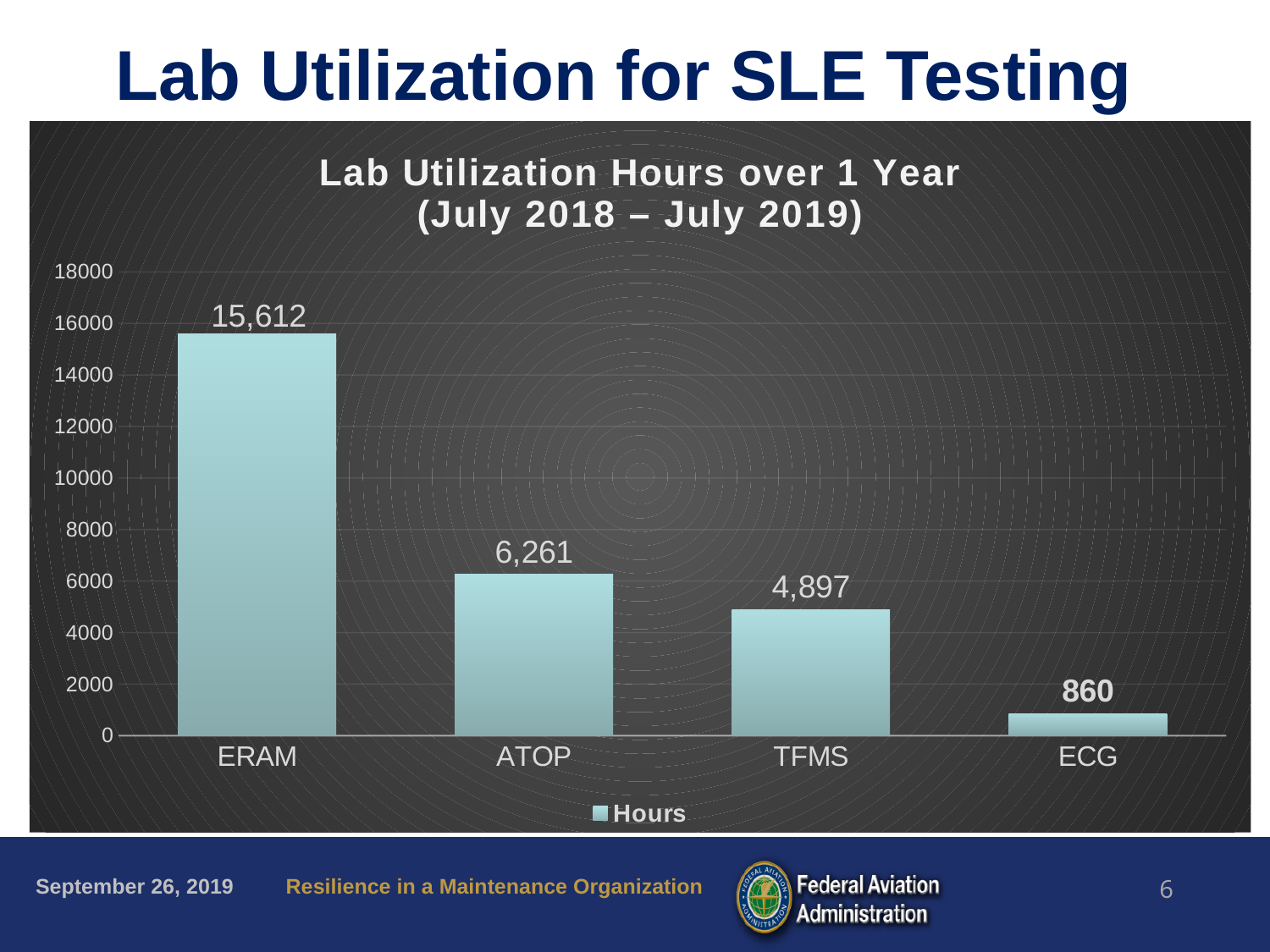
What is the value for ATOP? 6,261 Which category has the lowest value? ECG Which is larger, the value for TFMS or the value for ECG? TFMS How many categories are shown on the x axis? 4 What is the value for ECG? 860 Which category has the highest value? ERAM What is the difference between the values for ATOP and TFMS? 1,364 What is the title of the chart? Lab Utilization Hours over 1 Year (July 2018 – July 2019) What kind of chart is shown? Bar chart What is the difference between the values for ERAM and ATOP? 9,351 What is the value for ERAM? 15,612 What is the value for TFMS? 4,897